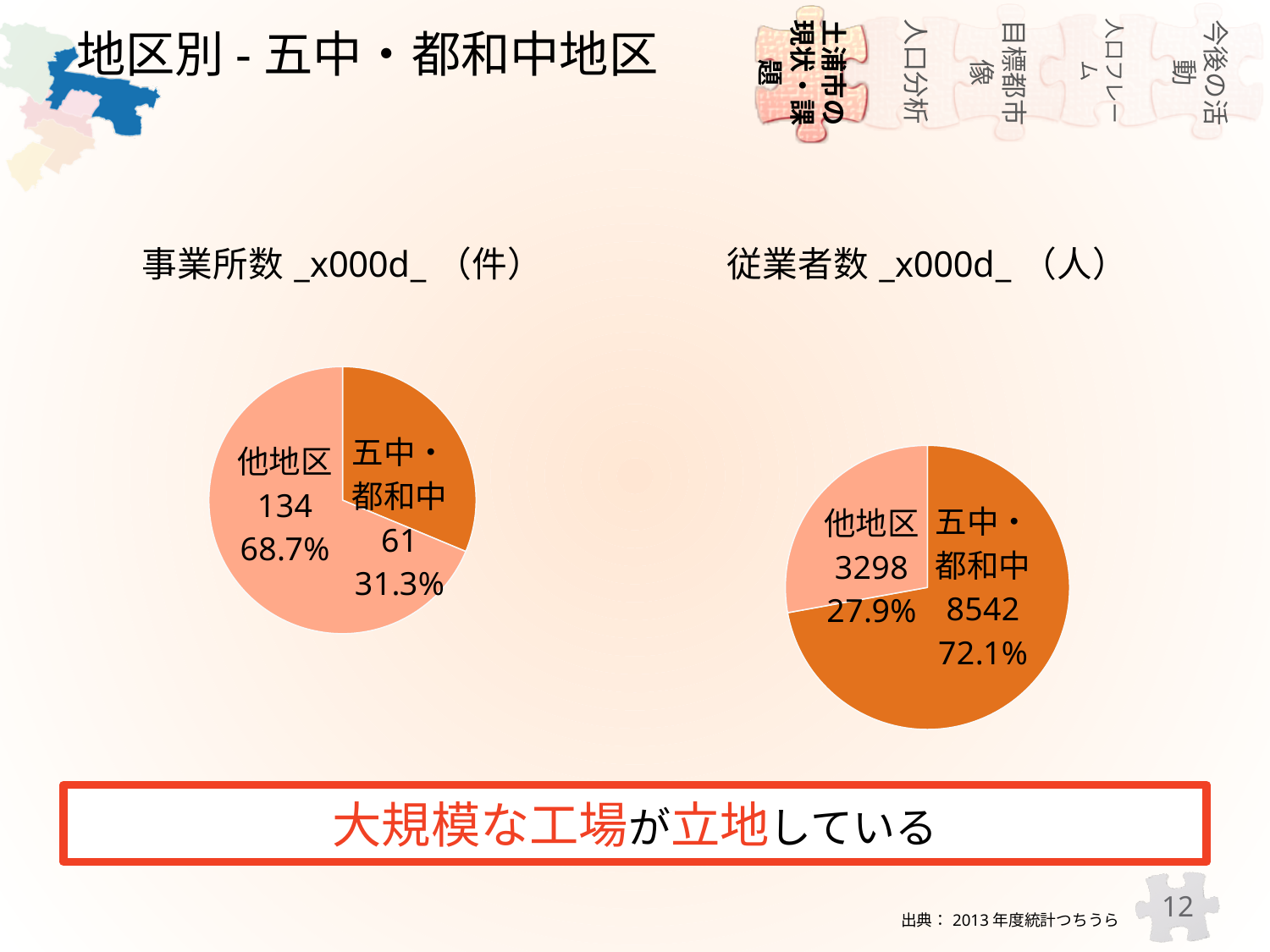
In the right chart (従業者数), what share of the pie does 他地区 have? 27.9% In the left chart (事業所数), what share of the pie does 五中・都和中 have? 31.3% What kind of chart is the left chart (事業所数)? pie chart In the left chart (事業所数), which category is the largest? 他地区 In the right chart (従業者数), which category is the smallest? 他地区 In the right chart (従業者数), what is the value for 他地区? 3298 In the left chart (事業所数), what is the difference between 他地区 and 五中・都和中? 73 In the left chart (事業所数), what is the value for 五中・都和中? 61 In the left chart (事業所数), what is the value for 他地区? 134 In the right chart (従業者数), what is the value for 五中・都和中? 8542 How many pie charts are shown on the slide? 2 In the right chart (従業者数), how many slices does the pie have? 2